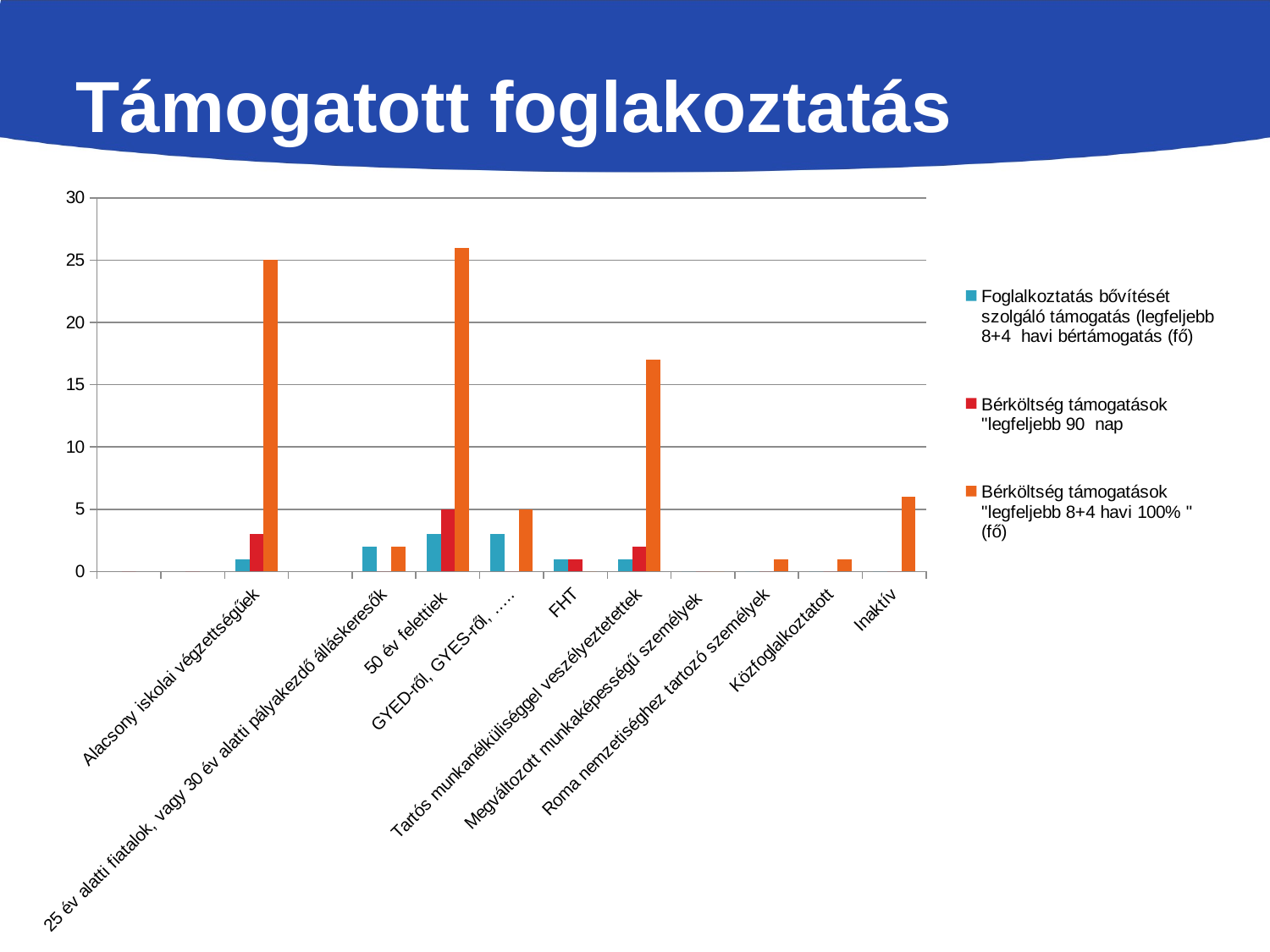
How many series does the legend list? 3 For '50 év felettiek', which series has the larger value: 'Foglalkoztatás bővítését szolgáló támogatás (legfeljebb 8+4 havi bértámogatás (fő)' or 'Bérköltség támogatások "legfeljebb 90 nap'? Bérköltség támogatások "legfeljebb 90 nap What kind of chart is shown on the slide? bar chart Which has the larger value in the 'Bérköltség támogatások "legfeljebb 8+4 havi 100% " (fő)' series: 'Alacsony iskolai végzettségűek' or 'Tartós munkanélküliséggel veszélyeztetettek'? Alacsony iskolai végzettségűek Is the value of the 'Bérköltség támogatások "legfeljebb 8+4 havi 100% " (fő)' series for '50 év felettiek' greater or less than 20? greater What colour represents the 'Bérköltség támogatások "legfeljebb 8+4 havi 100% " (fő)' series? orange What is the value of the 'Bérköltség támogatások "legfeljebb 90 nap' series for '50 év felettiek'? 5 What is the value of the 'Bérköltség támogatások "legfeljebb 8+4 havi 100% " (fő)' series for 'GYED-ről, GYES-ről, …..'? 5 What is the value of the 'Bérköltség támogatások "legfeljebb 8+4 havi 100% " (fő)' series for 'Alacsony iskolai végzettségűek'? 25 What is the title of the slide? Támogatott foglakoztatás Is the value of the 'Bérköltség támogatások "legfeljebb 8+4 havi 100% " (fő)' series for 'Tartós munkanélküliséggel veszélyeztetettek' greater or less than 15? greater Is the value of the 'Bérköltség támogatások "legfeljebb 8+4 havi 100% " (fő)' series for 'Inaktív' greater or less than 10? less